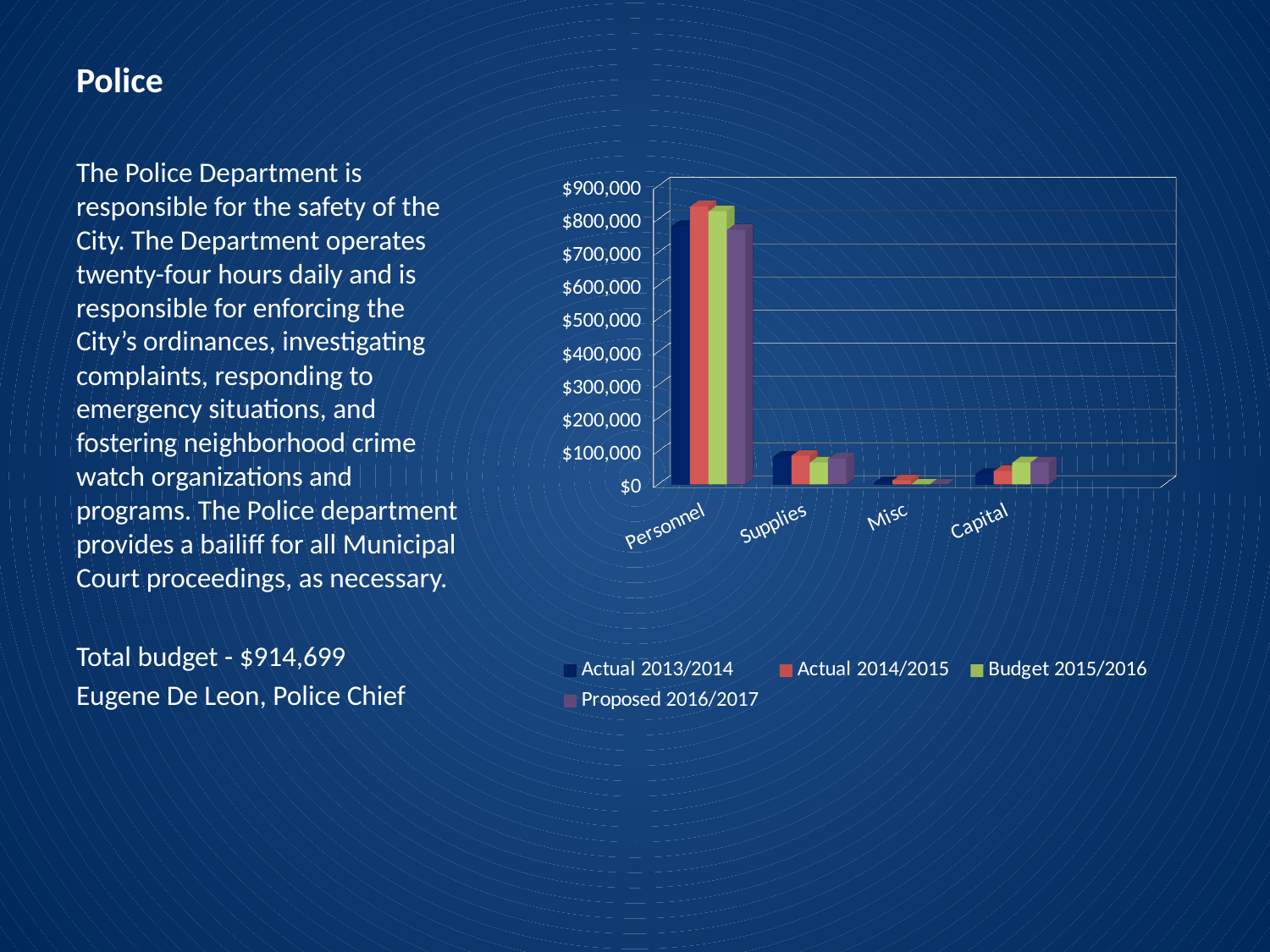
Which category has the lowest values in the chart? Misc For the Budget 2015/2016 series, which is larger: Misc or Capital? Capital How many categories are shown on the x axis of the chart? 4 Is the Proposed 2016/2017 value for Personnel greater or less than $800,000? less Is the Actual 2014/2015 value for Personnel greater or less than $800,000? greater How many series does the chart's legend list? 4 Which category has the highest values in the chart? Personnel Is the Actual 2013/2014 value for Supplies greater or less than $100,000? less What kind of chart is shown on the slide? bar chart Which series is shown in red in the chart's legend? Actual 2014/2015 For the Actual 2013/2014 series, which is larger: Personnel or Supplies? Personnel